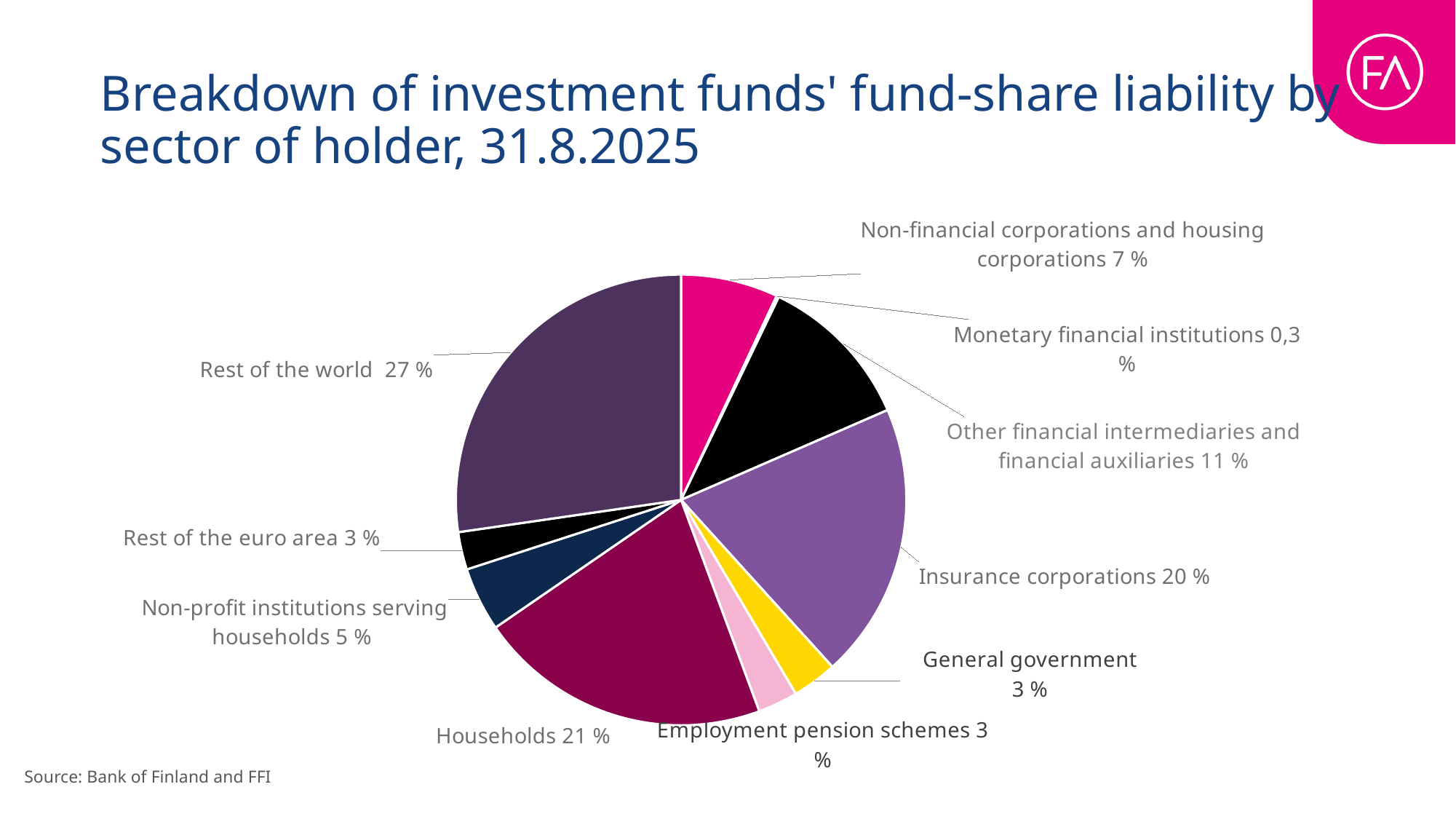
What share is held by Insurance corporations? 20 % Which is larger: the share of Other financial intermediaries and financial auxiliaries or the share of Non-financial corporations and housing corporations? Other financial intermediaries and financial auxiliaries What share is held by Monetary financial institutions? 0,3 % What kind of chart is shown on the slide? Pie chart Which sector of holder has the largest share of the pie? Rest of the world What is the difference in percentage points between the Rest of the world share and the Households share? 6 % Which sector of holder has the smallest share of the pie? Monetary financial institutions What share is held by Non-profit institutions serving households? 5 % What is the title of the chart on the slide? Breakdown of investment funds' fund-share liability by sector of holder, 31.8.2025 What share of investment funds' fund-share liability is held by Rest of the world? 27 % What share is held by Households? 21 % How many sectors of holder are shown in the pie chart? 10